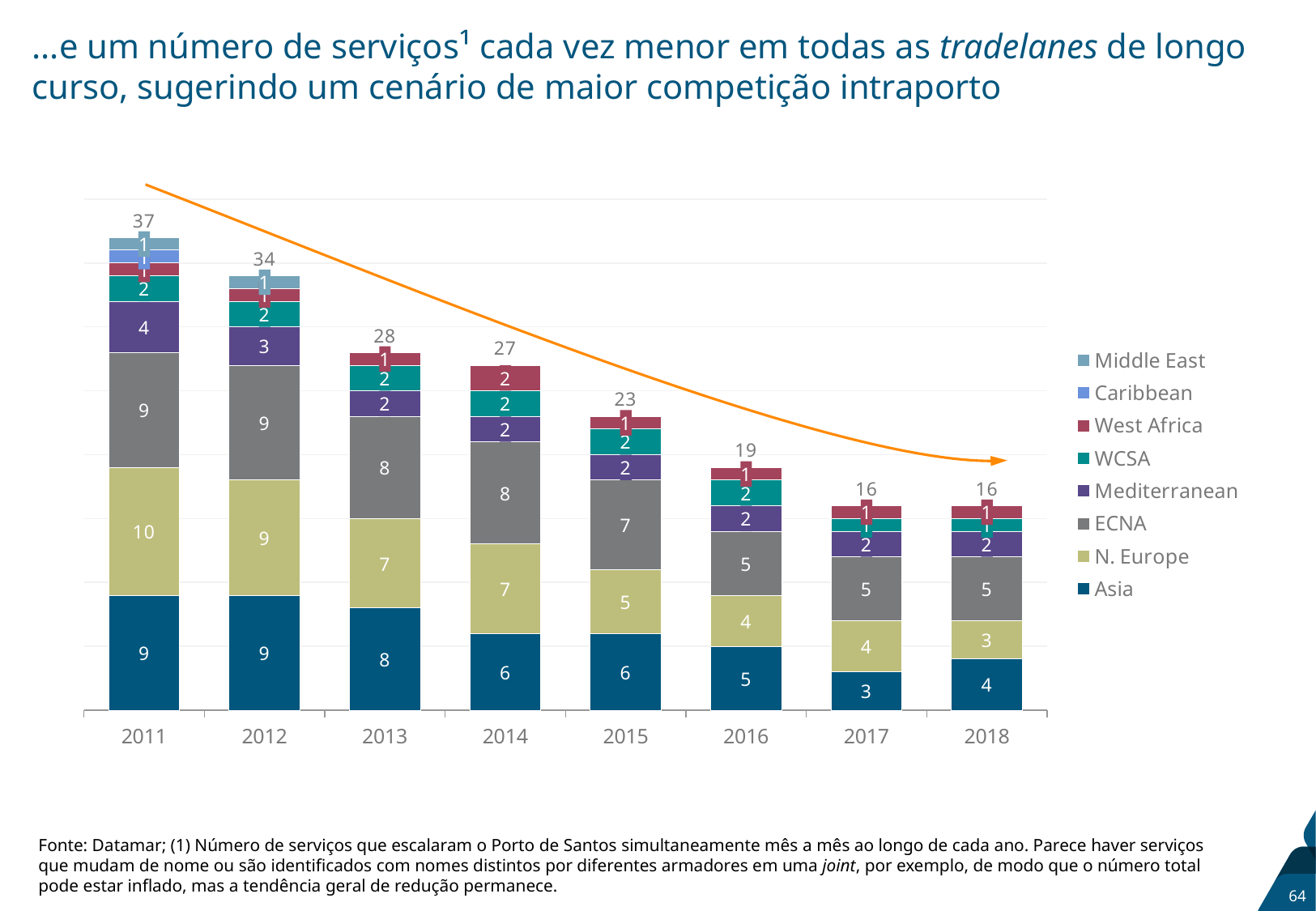
What kind of chart is shown on the slide? stacked bar chart Which is larger, the Asia value in 2011 or the Asia value in 2018? 2011 What is the value for Mediterranean in 2012? 3 How many years are shown on the x axis? 8 What is the value for ECNA in 2015? 7 Which year has the highest total number of services? 2011 What is the value for Asia in 2013? 8 What is the difference between the totals for 2011 and 2018? 21 How many series does the legend list? 8 What is the total number of services shown for 2011? 37 Do the total values rise or fall from 2011 to 2018? fall What is the value for N. Europe in 2011? 10